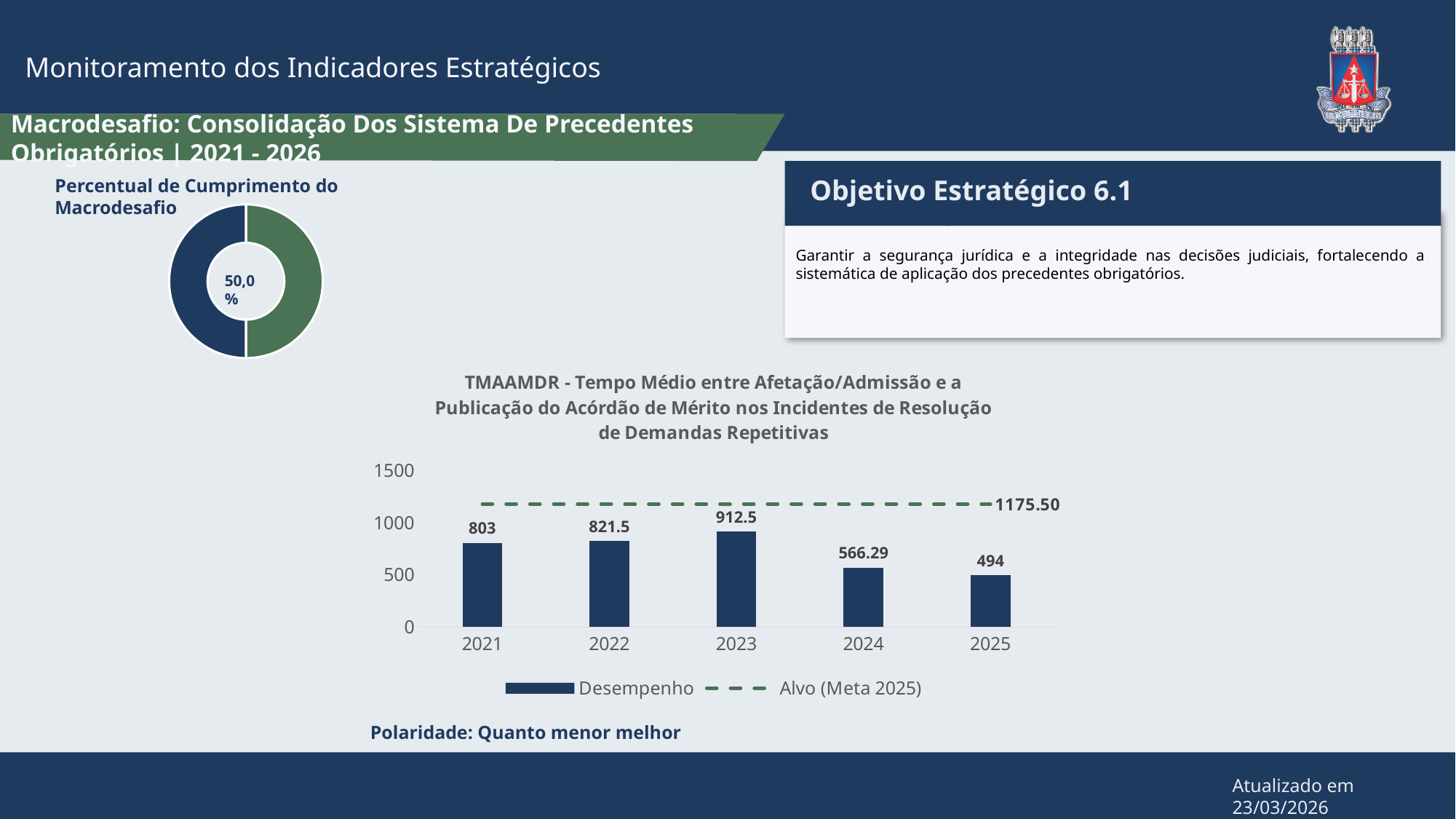
How many entries does the legend of the TMAAMDR chart list? 2 In the TMAAMDR bar chart, what is the Desempenho value for 2021? 803 In the TMAAMDR bar chart, which is larger, the value for 2021 or the value for 2022? 2022 In the TMAAMDR bar chart, which year has the lowest Desempenho value? 2025 How many years are shown on the x axis of the TMAAMDR bar chart? 5 What kind of chart is the 'Percentual de Cumprimento do Macrodesafio' chart? Donut chart In the TMAAMDR bar chart, what is the value of the Alvo (Meta 2025) line? 1175.50 In the TMAAMDR bar chart, which year has the highest Desempenho value? 2023 What percentage is shown in the centre of the 'Percentual de Cumprimento do Macrodesafio' chart? 50,0% In the TMAAMDR bar chart, what is the Desempenho value for 2024? 566.29 In the TMAAMDR bar chart, what is the difference between the 2023 value and the 2025 value? 418.5 In the TMAAMDR bar chart, is the value for 2024 greater or less than 1000? less